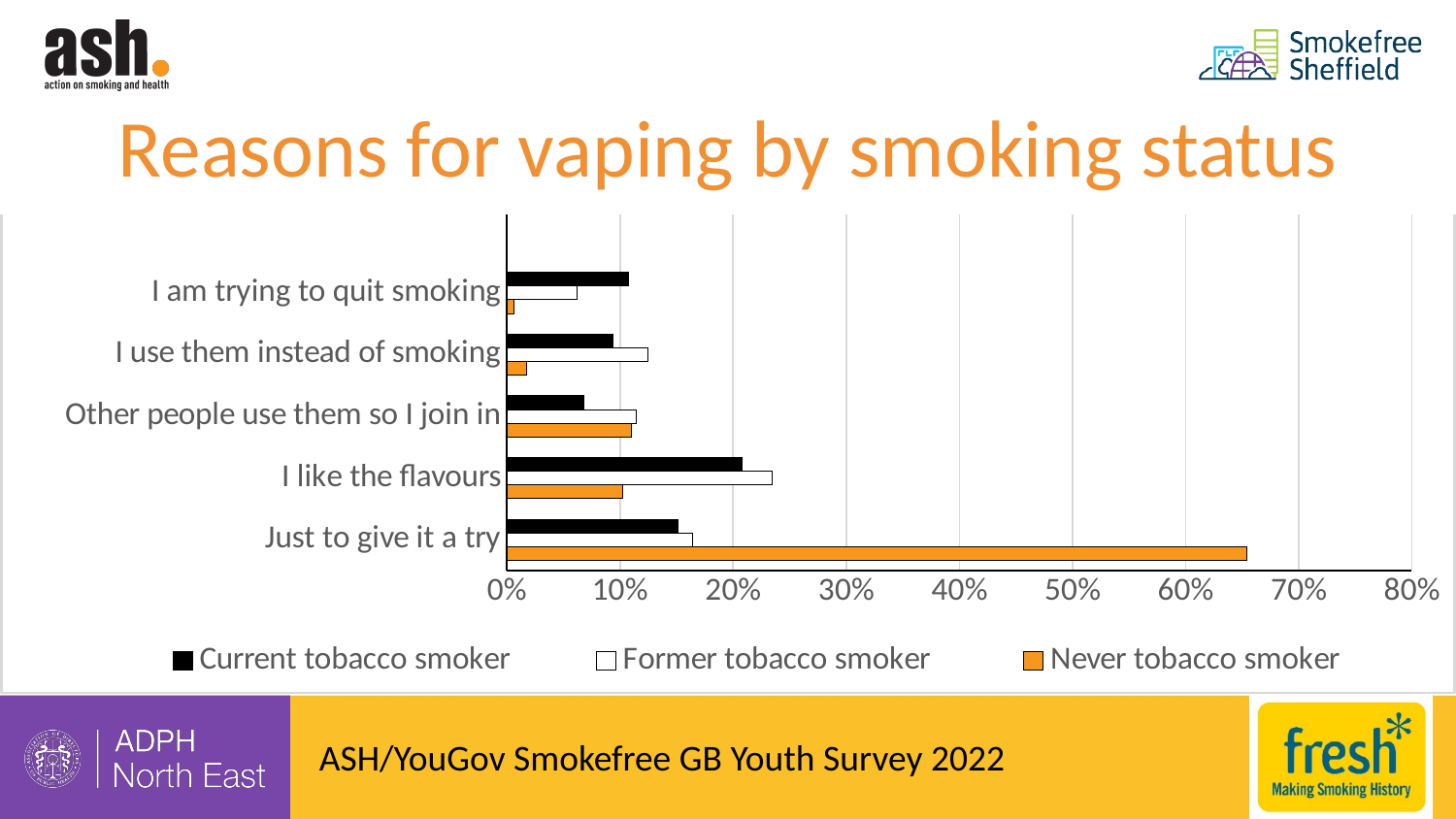
For 'Just to give it a try', which is larger: the value for Never tobacco smokers or Current tobacco smokers? Never tobacco smoker How many series does the legend list? 3 Is the value for Never tobacco smokers for 'Just to give it a try' greater or less than 60%? greater For Never tobacco smokers, which reason has the lowest value? I am trying to quit smoking For 'I am trying to quit smoking', which is larger: the value for Current tobacco smokers or Never tobacco smokers? Current tobacco smoker What kind of chart is shown on the slide? Bar chart For Current tobacco smokers, which reason has the highest value? I like the flavours What colour represents Never tobacco smokers in the chart? Orange Is the value for Never tobacco smokers for 'I am trying to quit smoking' greater or less than 10%? less For Never tobacco smokers, which reason has the highest value? Just to give it a try How many reasons for vaping (categories) are listed on the chart? 5 Is the value for Former tobacco smokers for 'I like the flavours' greater or less than 20%? greater